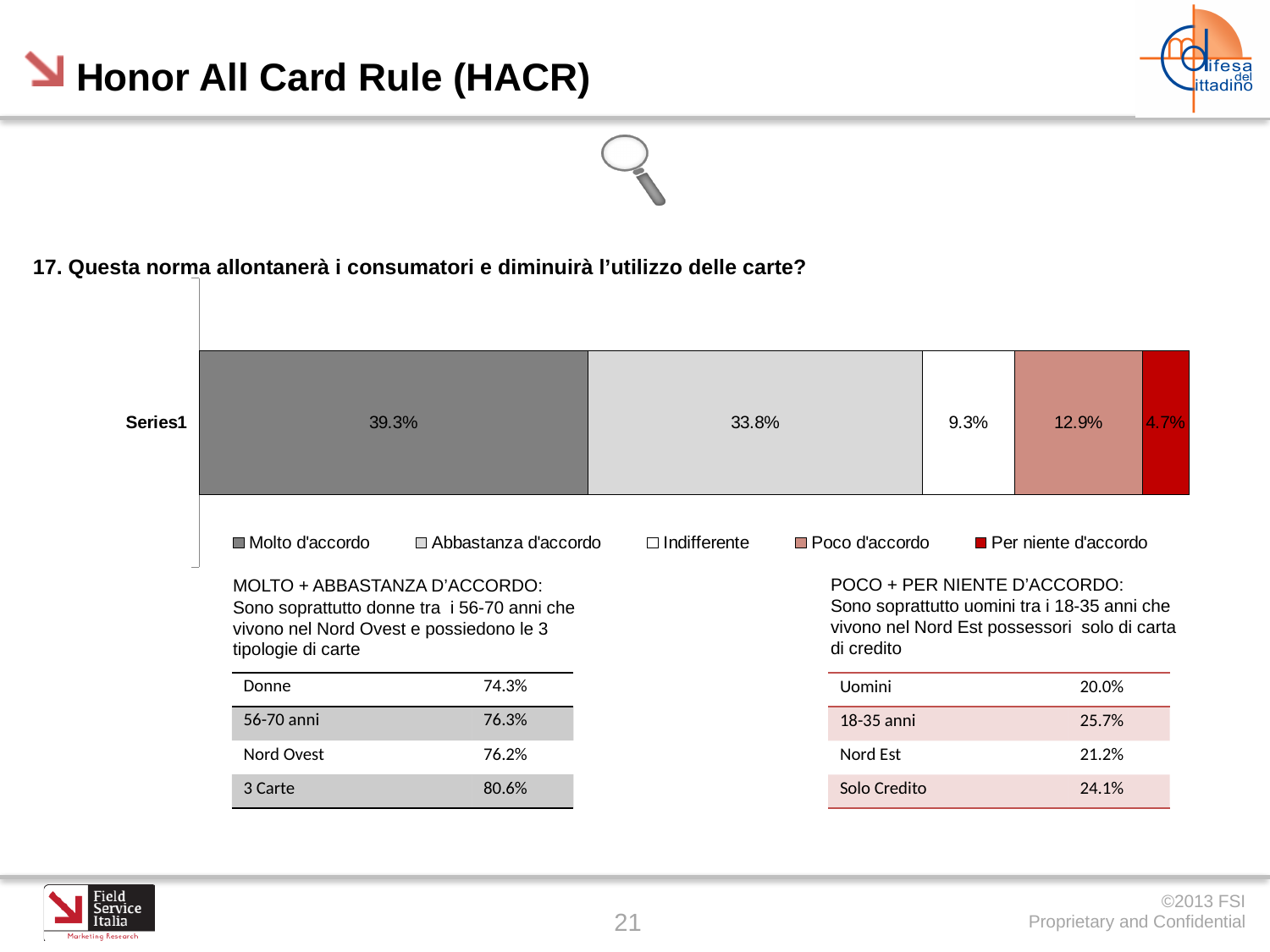
What is the difference between the 'Molto d'accordo' and 'Abbastanza d'accordo' percentages? 5.5% Which response category has the largest share? Molto d'accordo Which is larger, the share for 'Poco d'accordo' or for 'Indifferente'? Poco d'accordo How many series does the legend list? 5 Which response category has the smallest share? Per niente d'accordo What percentage of respondents answered 'Poco d'accordo'? 12.9% What percentage of respondents answered 'Abbastanza d'accordo'? 33.8% What percentage of respondents answered 'Indifferente'? 9.3% What kind of chart is shown on the slide? Stacked bar chart What percentage of respondents answered 'Per niente d'accordo'? 4.7% What is the combined total of 'Poco d'accordo' and 'Per niente d'accordo'? 17.6% What percentage of respondents answered 'Molto d'accordo'? 39.3%